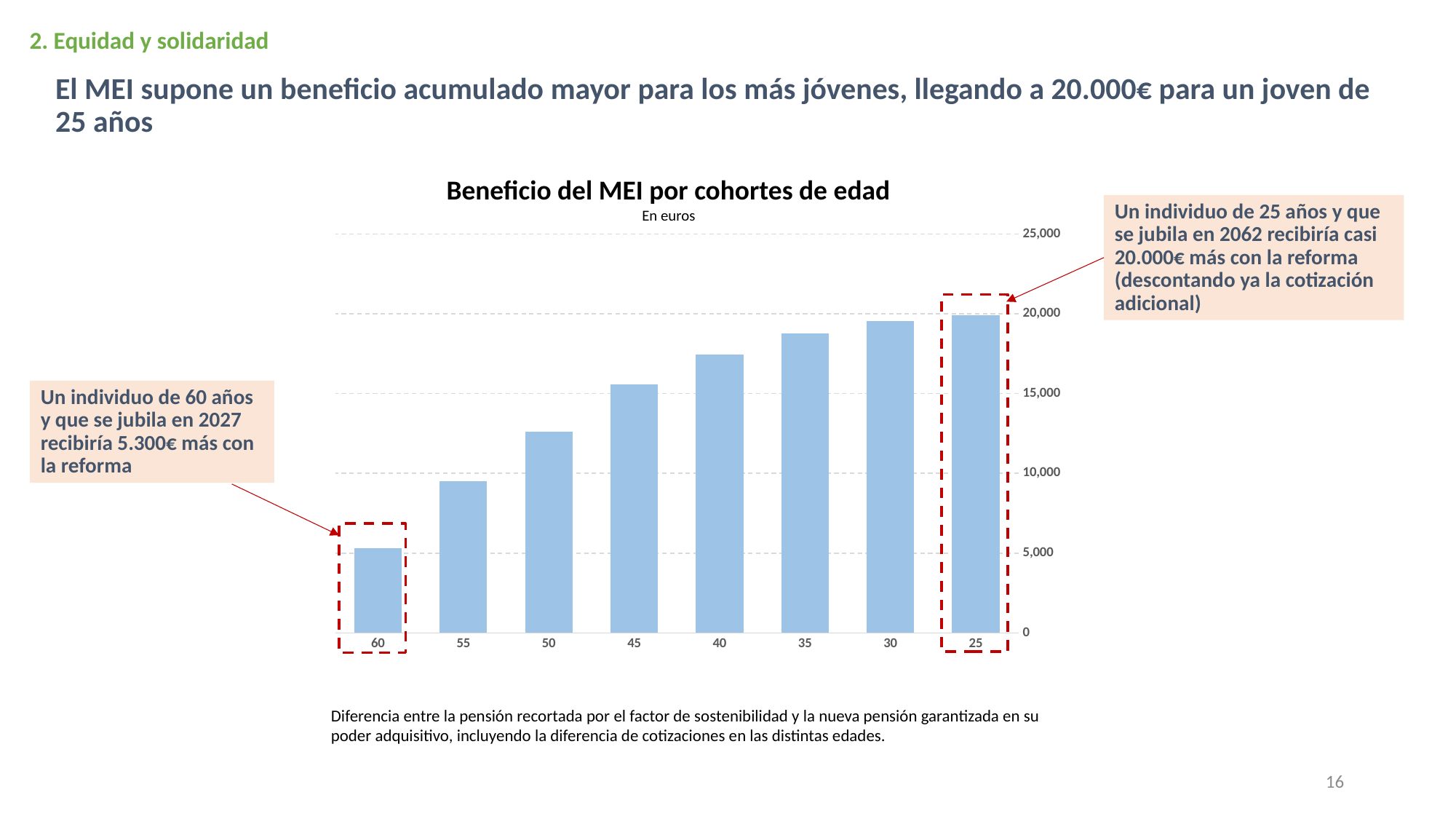
Which has a larger MEI benefit, the 50 cohort or the 40 cohort? 40 Is the value for the 50 cohort greater or less than 10,000? greater Which has a larger MEI benefit, the 60 cohort or the 55 cohort? 55 What is the title of the chart? Beneficio del MEI por cohortes de edad What kind of chart is shown on the slide? bar chart Is the value for the 60 cohort greater or less than 10,000? less Is the value for the 40 cohort greater or less than 15,000? greater How many age cohorts are plotted in the chart? 8 Do the values rise or fall moving along the x axis from the 60 cohort to the 25 cohort? rise Which age cohort has the lowest MEI benefit? 60